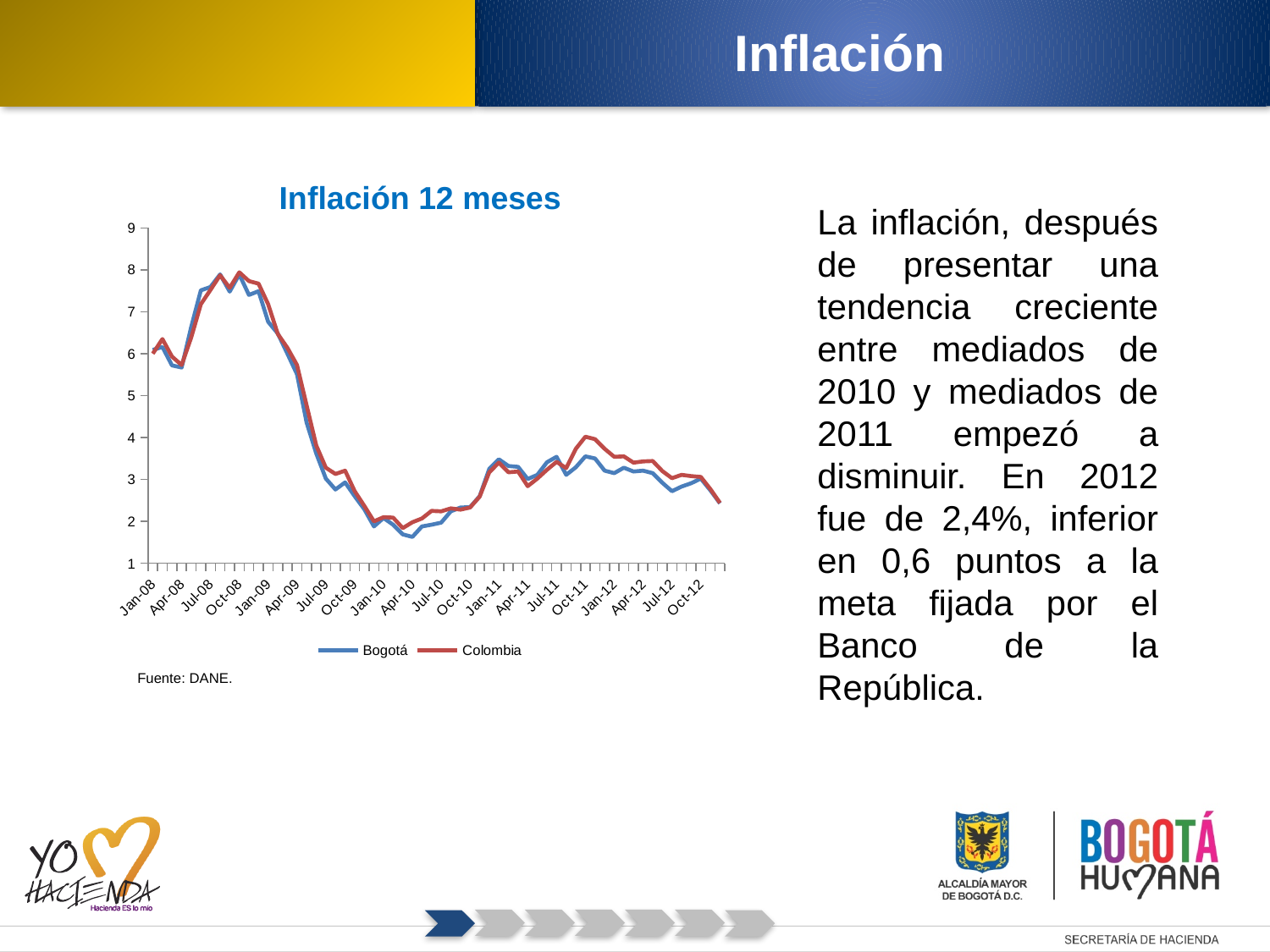
Do the values rise or fall between Oct-08 and Jan-10 in the chart? Fall In which year do the lines in the chart reach their highest values? 2008 Which series is drawn in red in the chart? Colombia Is the value for Bogotá at Jul-10 greater or less than 3? less Is the value for Colombia at Oct-08 greater or less than 7? greater How many labels are shown on the x axis of the chart? 20 Is the value for Bogotá at Apr-10 greater or less than 2? less What kind of chart is shown on the slide? Line chart What is the title of the chart? Inflación 12 meses At Oct-11, which series has the higher value, Bogotá or Colombia? Colombia Do the values rise or fall between Jan-08 and Oct-08 in the chart? Rise How many series does the legend of the chart list? 2